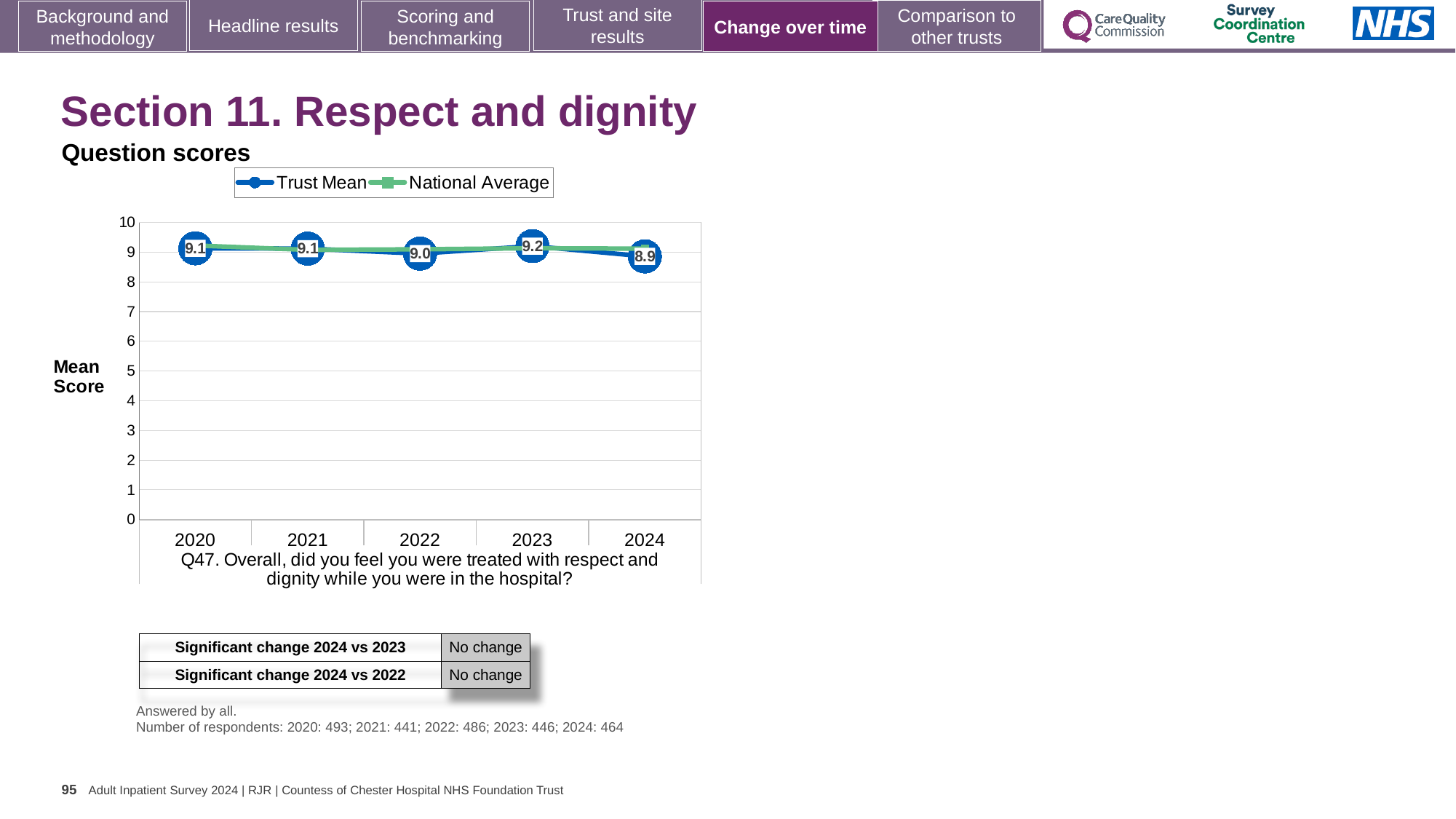
Is the Trust Mean score for 2024 greater or less than 8? greater Does the Trust Mean score rise or fall from 2023 to 2024? fall Which year has the larger Trust Mean score, 2022 or 2023? 2023 In which year is the Trust Mean score highest? 2023 In which year is the Trust Mean score lowest? 2024 What is the Trust Mean score for 2022? 9.0 How many series does the chart legend list? 2 What kind of chart is shown on the slide? line chart What is the Trust Mean score for 2024? 8.9 What is the Trust Mean score for 2020? 9.1 What is the difference between the Trust Mean scores for 2023 and 2024? 0.3 How many years are plotted on the x axis of the chart? 5